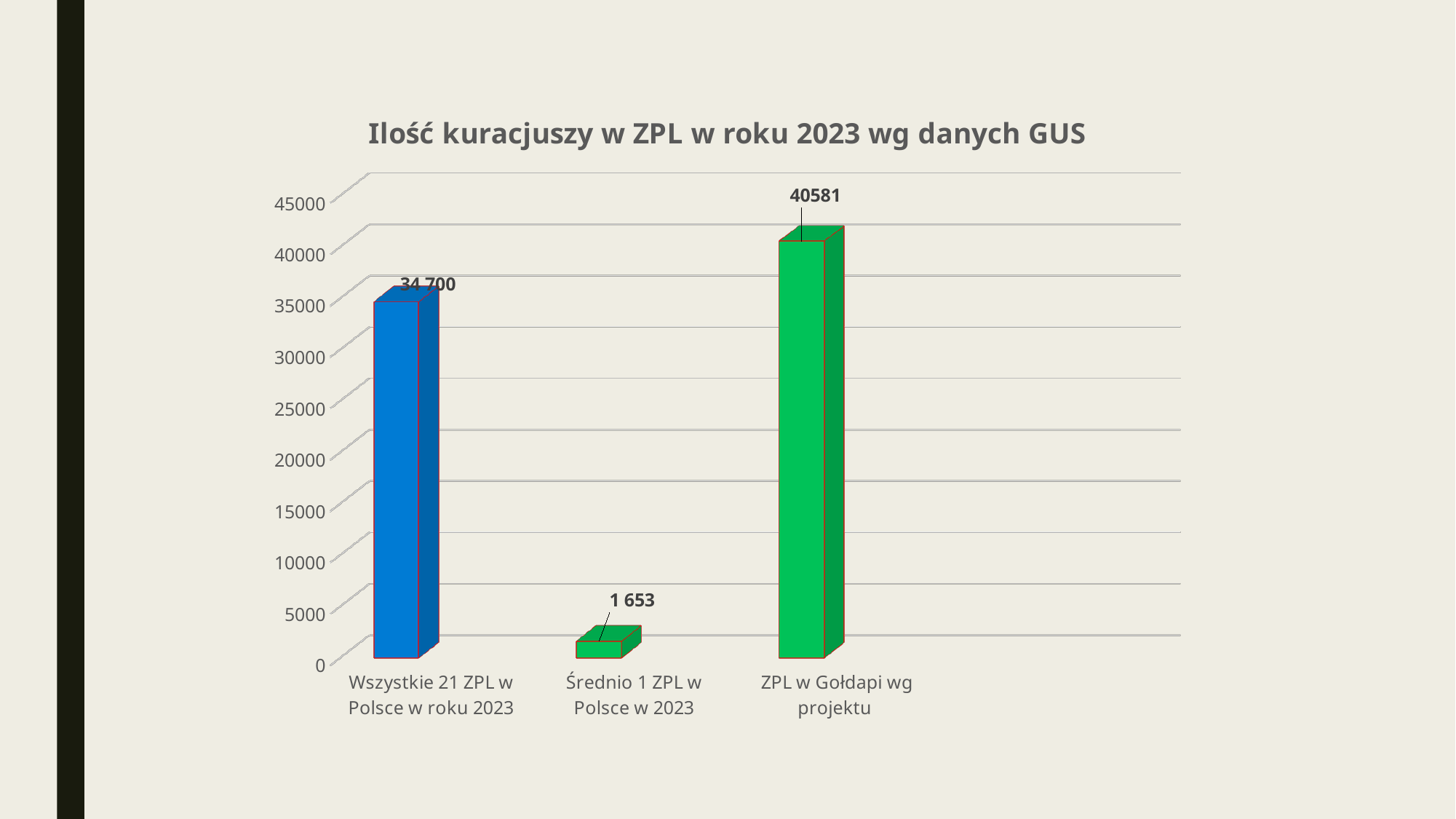
Is the value for "ZPL w Gołdapi wg projektu" greater or less than 40000? greater What kind of chart is shown on the slide? bar chart Which category has the highest value? ZPL w Gołdapi wg projektu How many categories are shown in the chart? 3 What is the value for "Średnio 1 ZPL w Polsce w 2023"? 1 653 What is the title of the chart? Ilość kuracjuszy w ZPL w roku 2023 wg danych GUS What is the value for "Wszystkie 21 ZPL w Polsce w roku 2023"? 34 700 What is the value for "ZPL w Gołdapi wg projektu"? 40581 What is the difference between the values for "ZPL w Gołdapi wg projektu" and "Wszystkie 21 ZPL w Polsce w roku 2023"? 5881 Which category has the lowest value? Średnio 1 ZPL w Polsce w 2023 Which is larger: the value for "Wszystkie 21 ZPL w Polsce w roku 2023" or for "ZPL w Gołdapi wg projektu"? ZPL w Gołdapi wg projektu What is the difference between the values for "Wszystkie 21 ZPL w Polsce w roku 2023" and "Średnio 1 ZPL w Polsce w 2023"? 33047